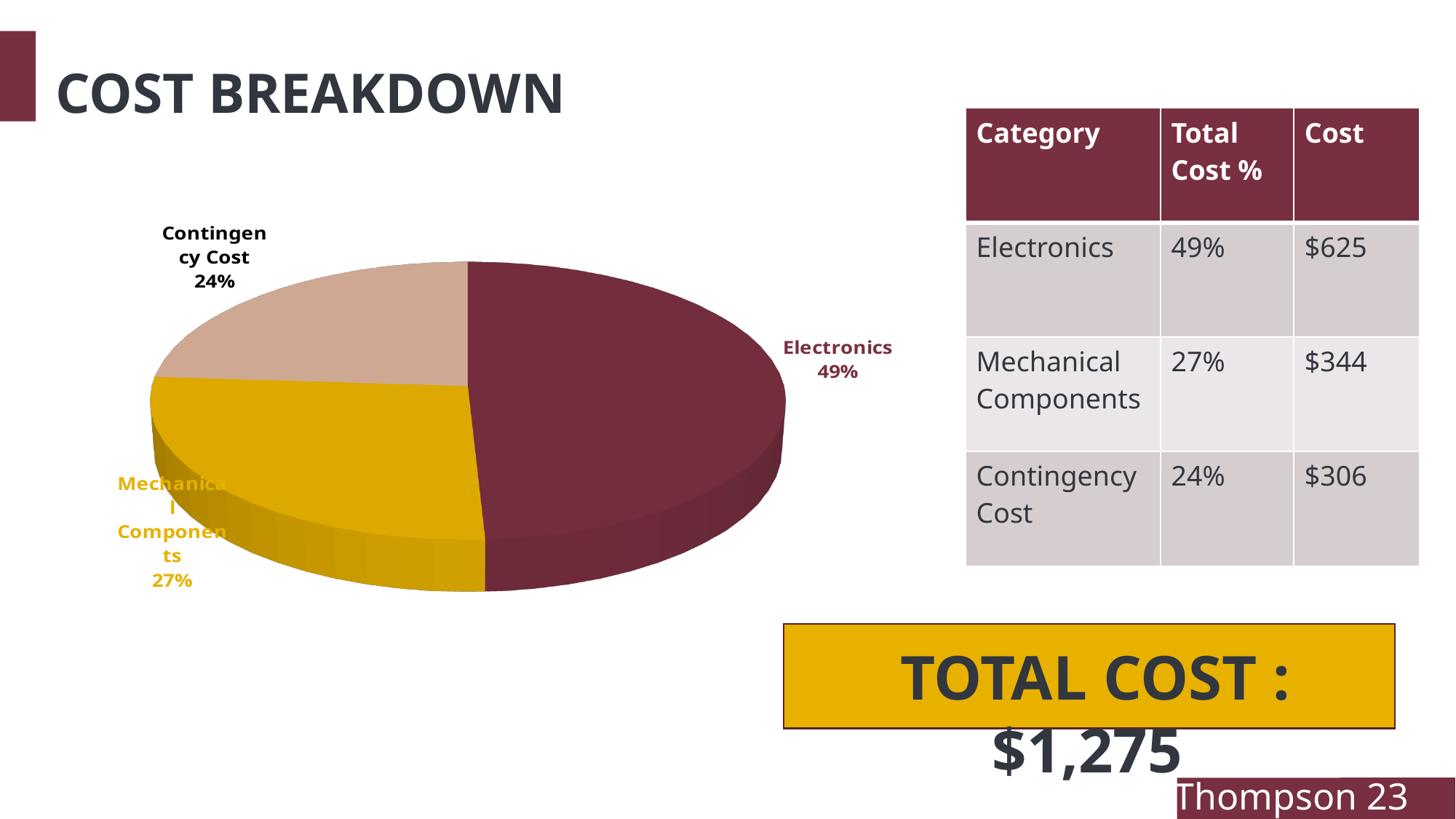
How many slices does the pie chart have? 3 What percentage does the Electronics slice show? 49% Which category has the smallest slice of the pie? Contingency Cost What share of the pie does Electronics take? 49% What kind of chart is shown on the slide? Pie chart What percentage does the Contingency Cost slice show? 24% Which category has the largest slice of the pie? Electronics What is the difference in percentage points between the Electronics slice and the Mechanical Components slice? 22 What colour is the Electronics slice? Dark red What colour is the Mechanical Components slice? Yellow What percentage does the Mechanical Components slice show? 27% Which slice is larger, Mechanical Components or Contingency Cost? Mechanical Components